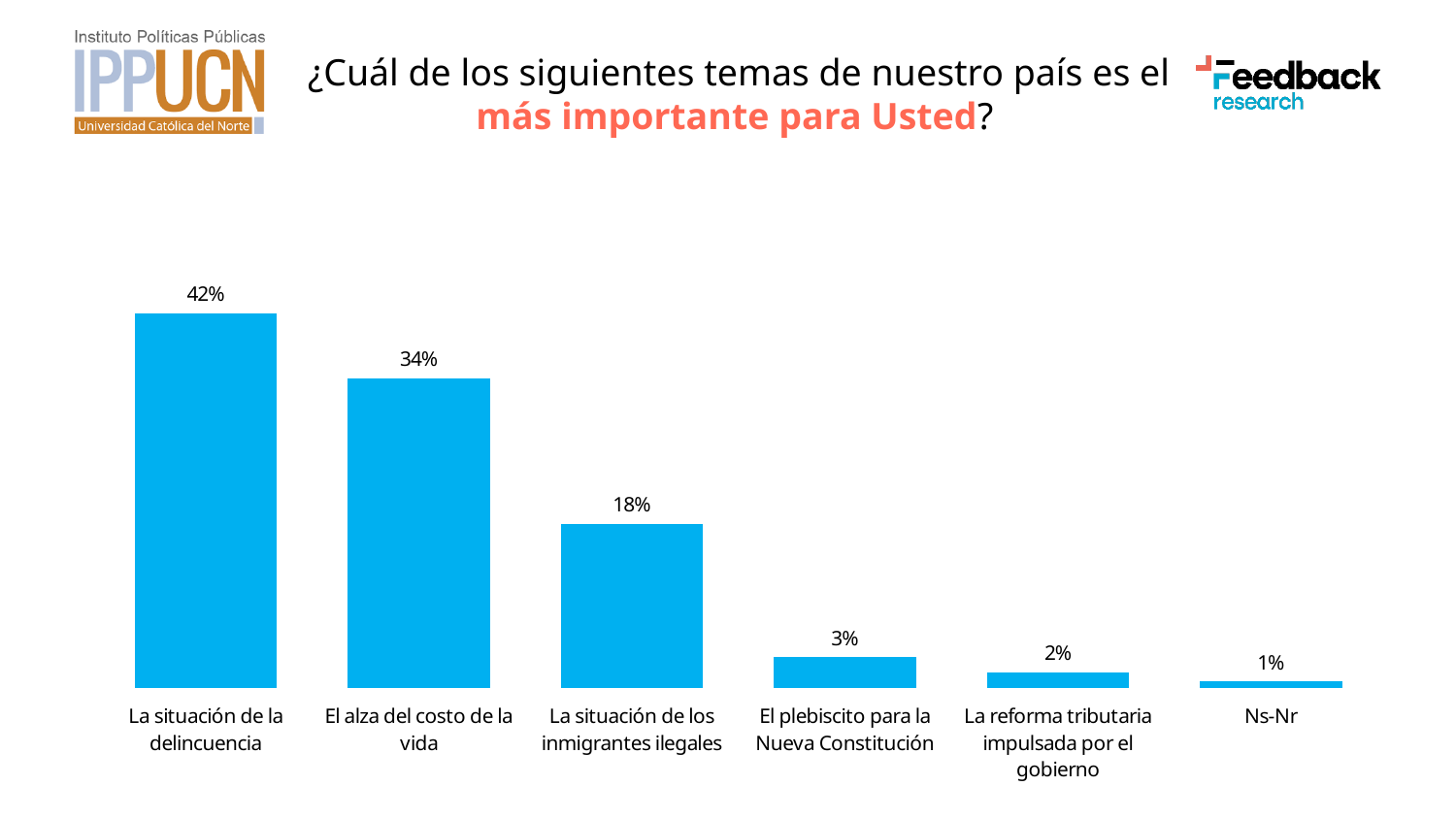
What is the difference between the values for "La situación de la delincuencia" and "El alza del costo de la vida"? 8% What is the value for "El plebiscito para la Nueva Constitución"? 3% What is the value for "La situación de la delincuencia"? 42% What is the value for "La situación de los inmigrantes ilegales"? 18% Which category has the highest value? La situación de la delincuencia Do the values rise or fall from left to right along the x axis? Fall Which is larger, the value for "La reforma tributaria impulsada por el gobierno" or the value for "El plebiscito para la Nueva Constitución"? El plebiscito para la Nueva Constitución Which category has the lowest value? Ns-Nr What is the value for "El alza del costo de la vida"? 34% What kind of chart is shown on the slide? Bar chart What is the value for "Ns-Nr"? 1% How many categories are shown in the chart? 6